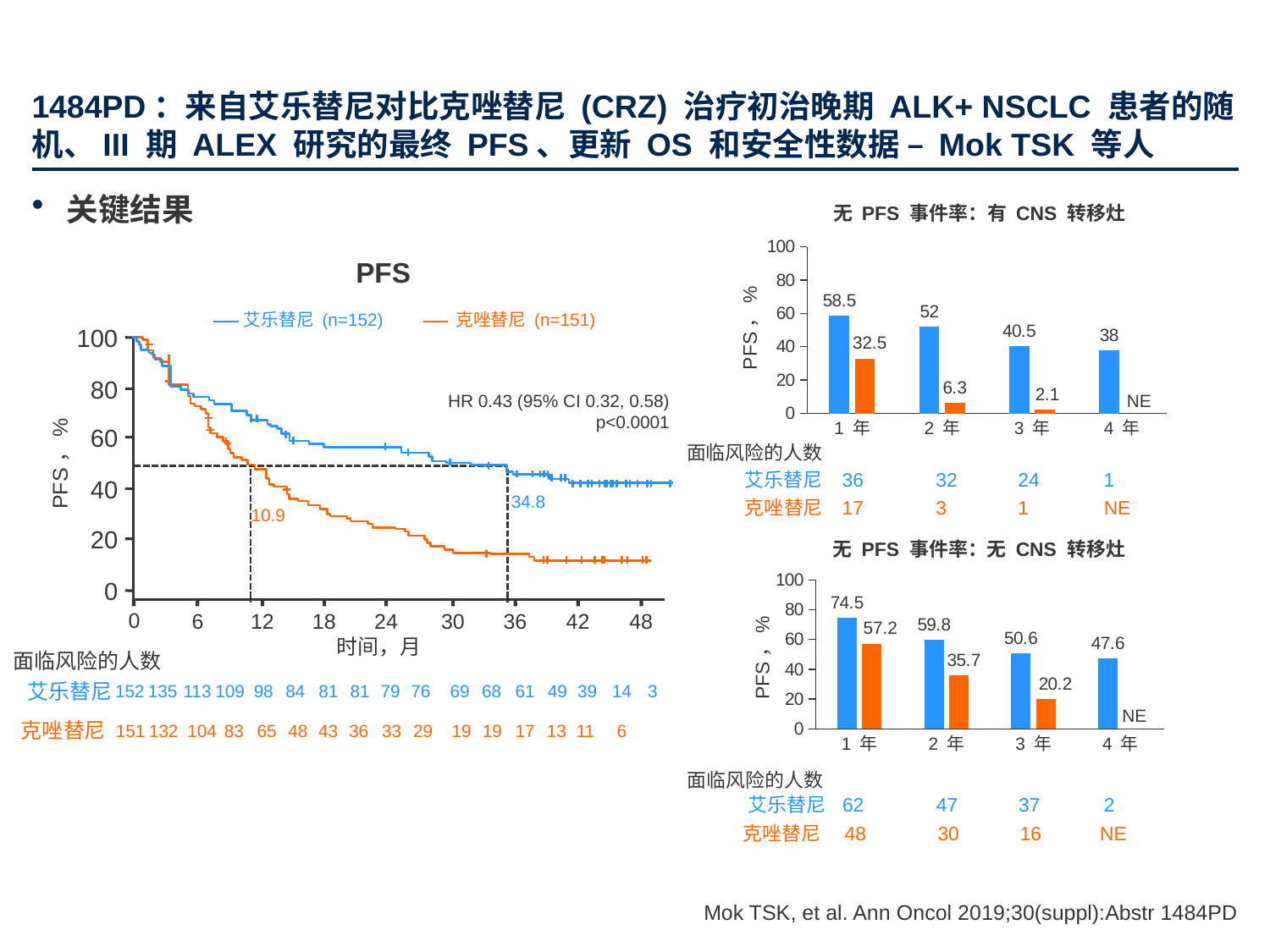
What kind of chart is the PFS chart on the left? line chart In the "无 PFS 事件率：无 CNS 转移灶" chart, at which time point is the 艾乐替尼 value highest? 1 年 In the "无 PFS 事件率：有 CNS 转移灶" chart, do the 艾乐替尼 values rise or fall from 1 年 to 4 年? fall In the "无 PFS 事件率：有 CNS 转移灶" chart, which treatment has the larger value at 3 年? 艾乐替尼 How many series does the legend of the PFS chart list? 2 In the "无 PFS 事件率：有 CNS 转移灶" chart, what is the lowest printed value for 克唑替尼? 2.1 In the PFS chart, what median PFS value is marked for 克唑替尼? 10.9 In the "无 PFS 事件率：有 CNS 转移灶" chart, what is the difference between the 艾乐替尼 and 克唑替尼 values at 2 年? 45.7 In the "无 PFS 事件率：无 CNS 转移灶" chart, what is the difference between the 艾乐替尼 and 克唑替尼 values at 1 年? 17.3 In the "无 PFS 事件率：无 CNS 转移灶" chart, what is the value for 克唑替尼 at 2 年? 35.7 In the "无 PFS 事件率：有 CNS 转移灶" chart, what is the value for 艾乐替尼 at 1 年? 58.5 In the "无 PFS 事件率：无 CNS 转移灶" chart, how many time points are shown on the x axis? 4